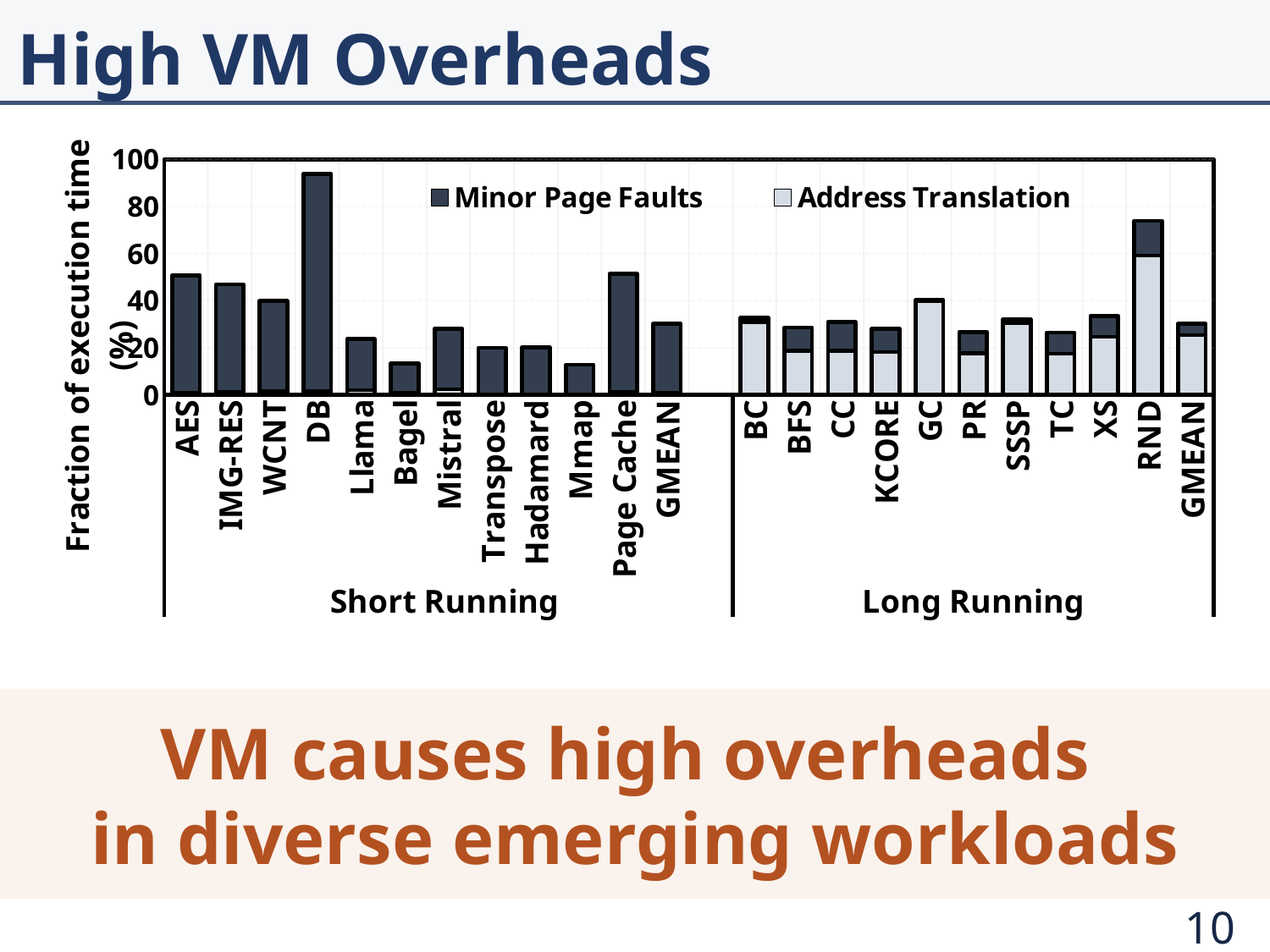
How many series does the legend list? 2 Which workload has the highest total fraction of execution time? DB Is the total value for Mmap greater or less than 20? less What are the two workload groups labelled below the x axis? Short Running and Long Running How many workloads are plotted in the Long Running group? 11 Is the total value for DB greater or less than 80? greater What are the two series named in the legend? Minor Page Faults and Address Translation Is the total value for RND greater or less than 60? greater Which has the larger total bar, Page Cache or Llama? Page Cache Which workload in the Long Running group has the highest total bar? RND How many workloads are plotted in the Short Running group? 12 What kind of chart is shown on the slide? bar chart